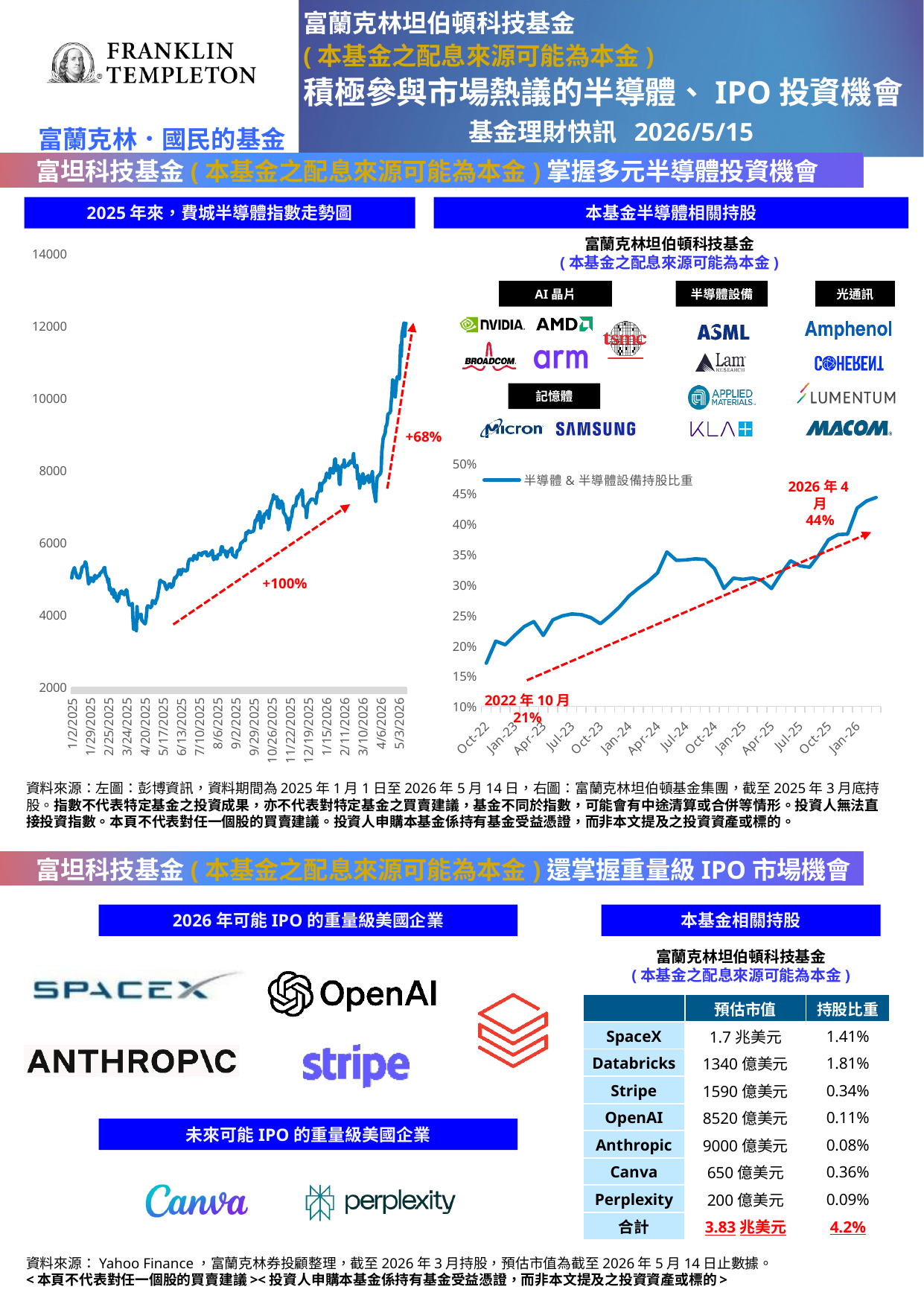
What kind of chart is the left chart titled 2025年來，費城半導體指數走勢圖? line chart What kind of chart is the right chart titled 本基金半導體相關持股? line chart In the right chart (本基金半導體相關持股), what is the holding share labelled for 2022年10月? 21% In the left chart (2025年來，費城半導體指數走勢圖), what percentage gain is labelled on the first red dashed arrow? +100% In the right chart (本基金半導體相關持股), what is the holding share labelled for 2026年4月? 44% In the left chart (2025年來，費城半導體指數走勢圖), is the index value at 1/2/2025 greater or less than 6000? less In the right chart (本基金半導體相關持股), does the holding share generally rise or fall from Oct-22 to Jan-26? rise How many series does the legend of the right chart (本基金半導體相關持股) list? 1 What is the legend entry of the right chart (本基金半導體相關持股)? 半導體 & 半導體設備持股比重 In the left chart (2025年來，費城半導體指數走勢圖), what percentage gain is labelled on the second red dashed arrow near the end of the series? +68% In the left chart (2025年來，費城半導體指數走勢圖), is the index value at 5/3/2026 greater or less than 10000? greater In the right chart (本基金半導體相關持股), by how many percentage points did the holding share rise from 2022年10月 (21%) to 2026年4月 (44%)? 23 percentage points